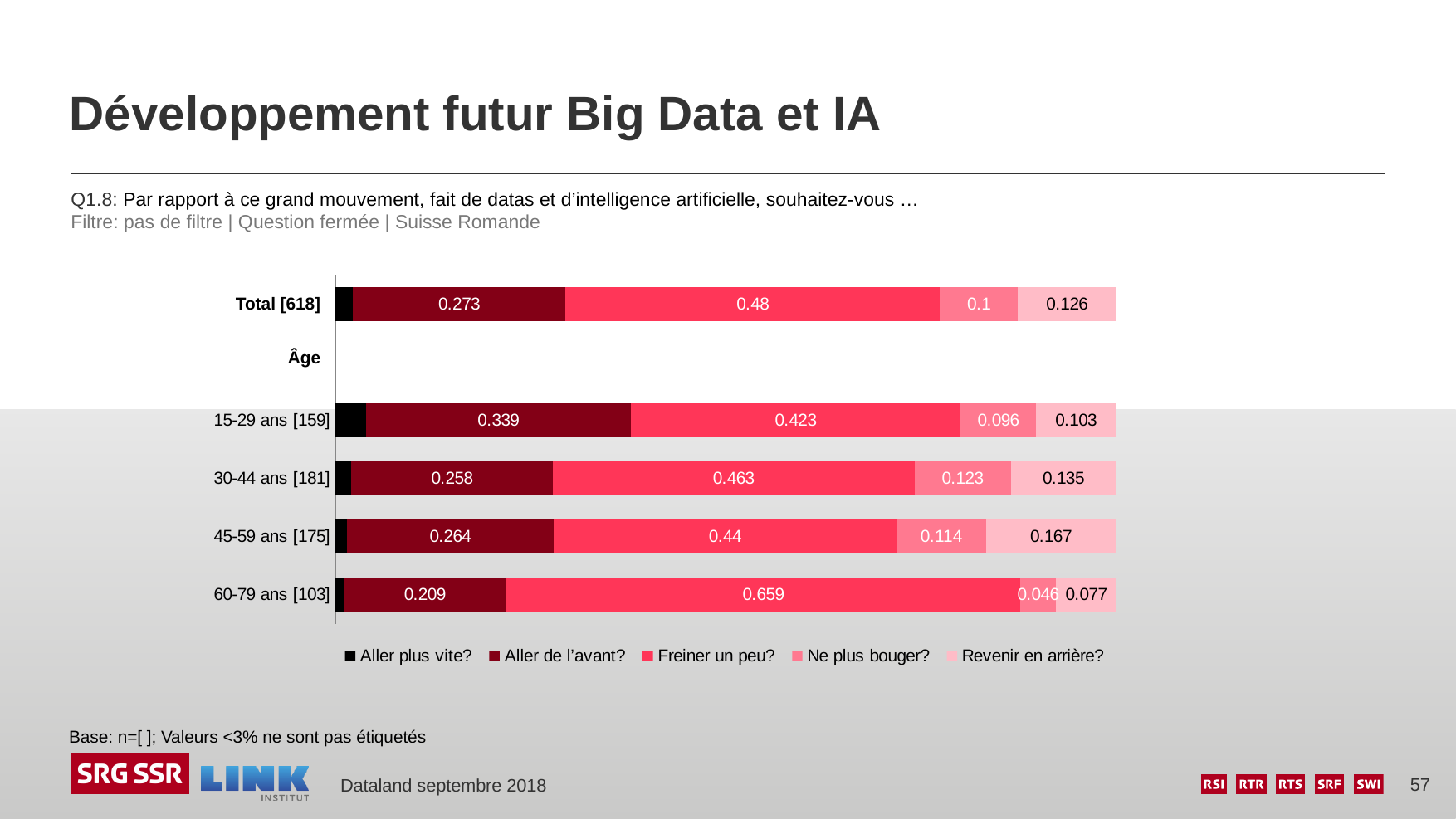
What is the value of "Freiner un peu?" for the 60-79 ans [103] group? 0.659 How many bars (categories) are plotted in the chart? 5 What is the value of "Revenir en arrière?" for the 45-59 ans [175] group? 0.167 Which has the larger "Ne plus bouger?" value: 30-44 ans [181] or 45-59 ans [175]? 30-44 ans [181] Which age group has the highest value for "Freiner un peu?"? 60-79 ans [103] Which age group has the lowest value for "Revenir en arrière?"? 60-79 ans [103] What is the value of "Aller de l’avant?" for the 15-29 ans [159] group? 0.339 What is the value of "Ne plus bouger?" for Total [618]? 0.1 How many series does the legend list? 5 Which age group has the highest value for "Aller de l’avant?"? 15-29 ans [159] What kind of chart is shown on the slide? Stacked bar chart What is the difference between the "Freiner un peu?" values for 60-79 ans [103] and 15-29 ans [159]? 0.236